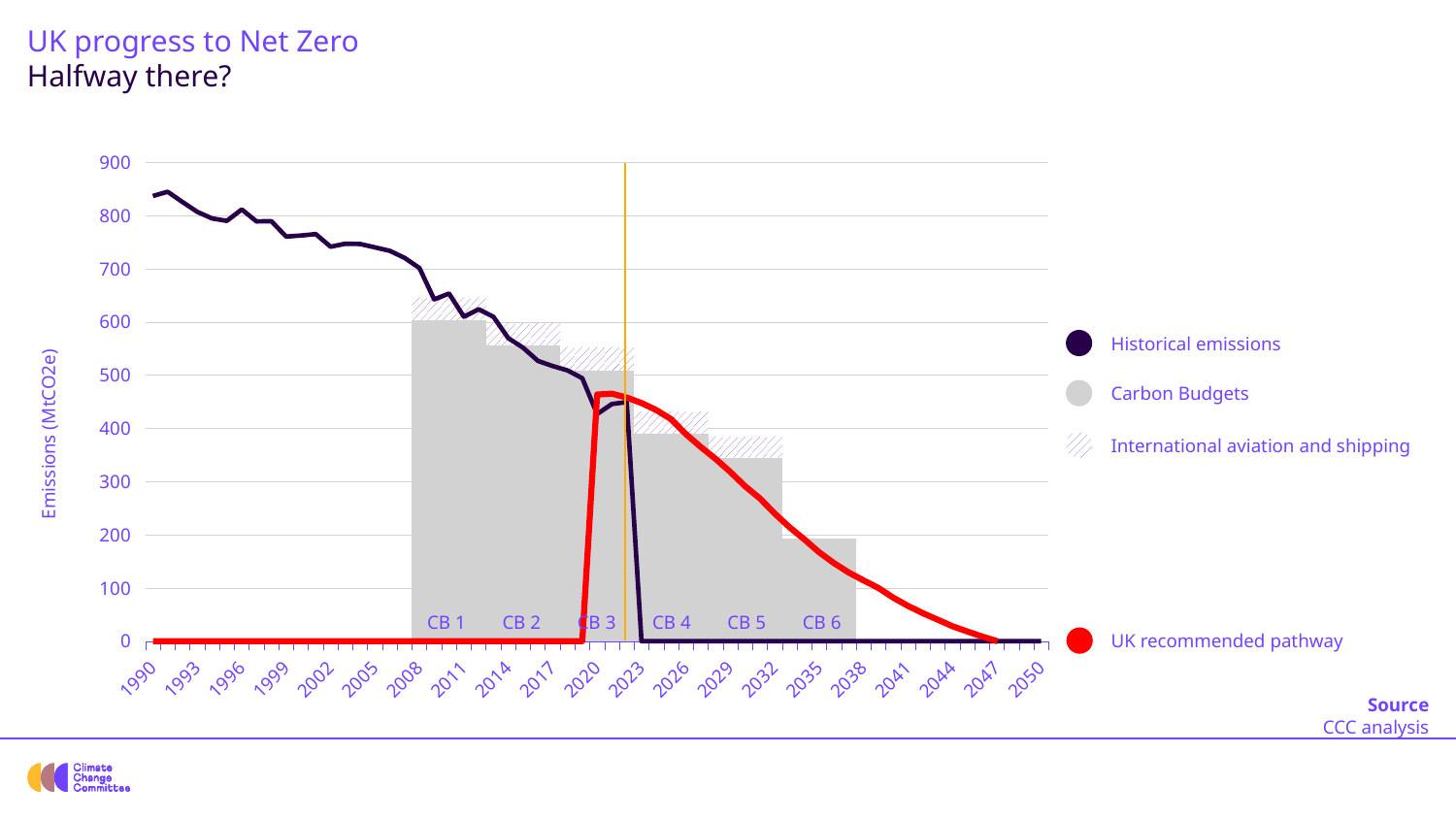
How many carbon budgets (CB) are labelled on the chart? 6 What is the label on the y axis? Emissions (MtCO2e) Is the historical emissions value for 1990 greater or less than 800? greater What colour is the UK recommended pathway line? red What kind of chart is shown on the slide? combination bar and line chart Which carbon budget has the highest level, CB 1 or CB 6? CB 1 How many entries does the legend list? 4 Which of the labelled carbon budgets has the lowest level? CB 6 Do historical emissions rise or fall between 1990 and 2023? fall Is the Carbon Budget level for CB 6 greater or less than 300? less Is the UK recommended pathway value for 2044 greater or less than 100? less